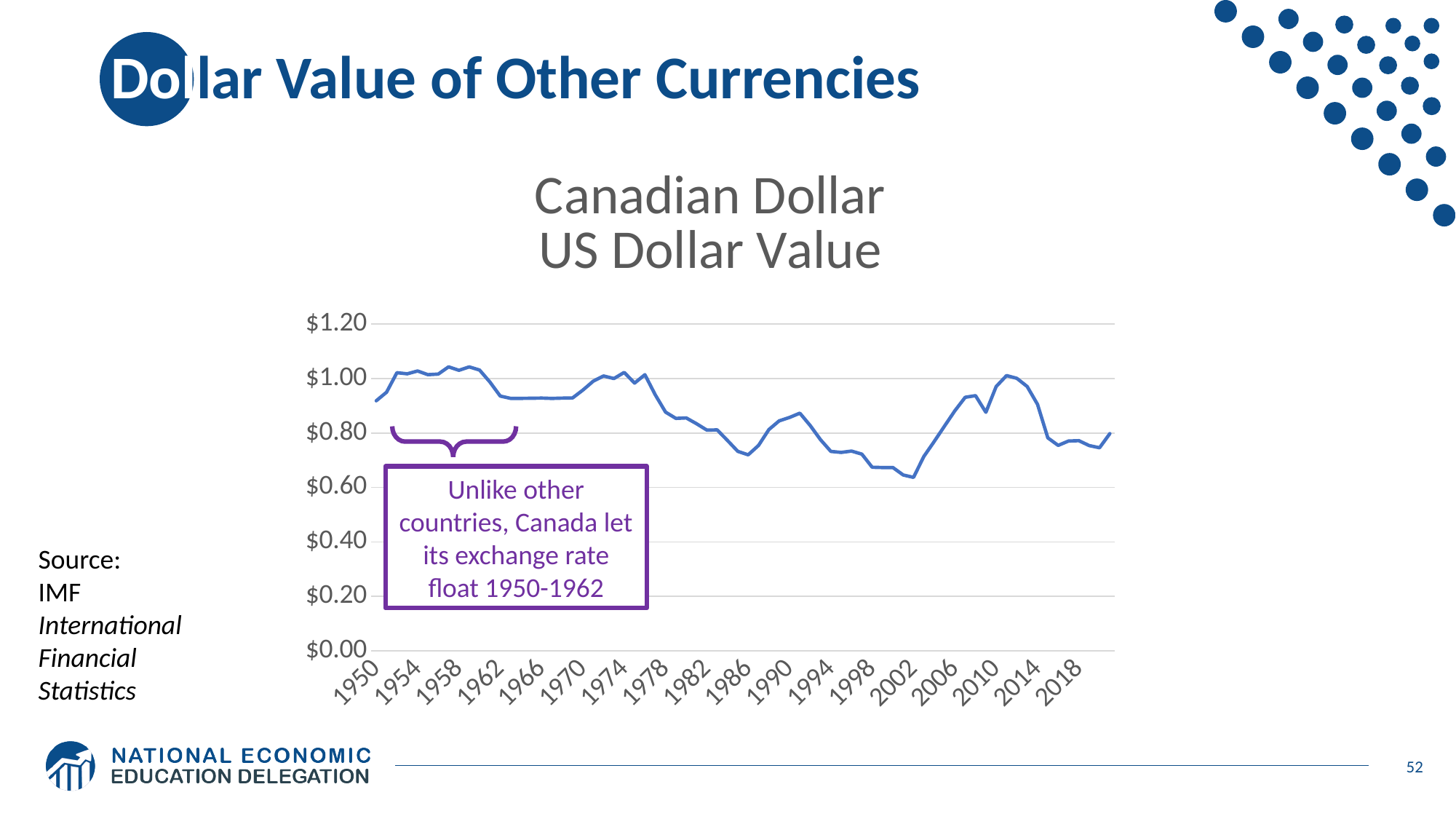
Between 1974 and 2002, does the value of the Canadian dollar generally rise or fall? fall What kind of chart is shown on the slide? line chart What is the title of the chart? Canadian Dollar US Dollar Value Is the value for 2002 greater or less than $0.80? less Which year has the larger value, 1958 or 2002? 1958 What is the highest value shown on the vertical axis of the chart? $1.20 Is the value for 1950 greater or less than $0.80? greater Around which labelled year does the Canadian dollar reach its lowest value on the chart? 2002 Is the value for 1978 greater or less than $1.00? less How many year labels are shown along the x axis of the chart? 18